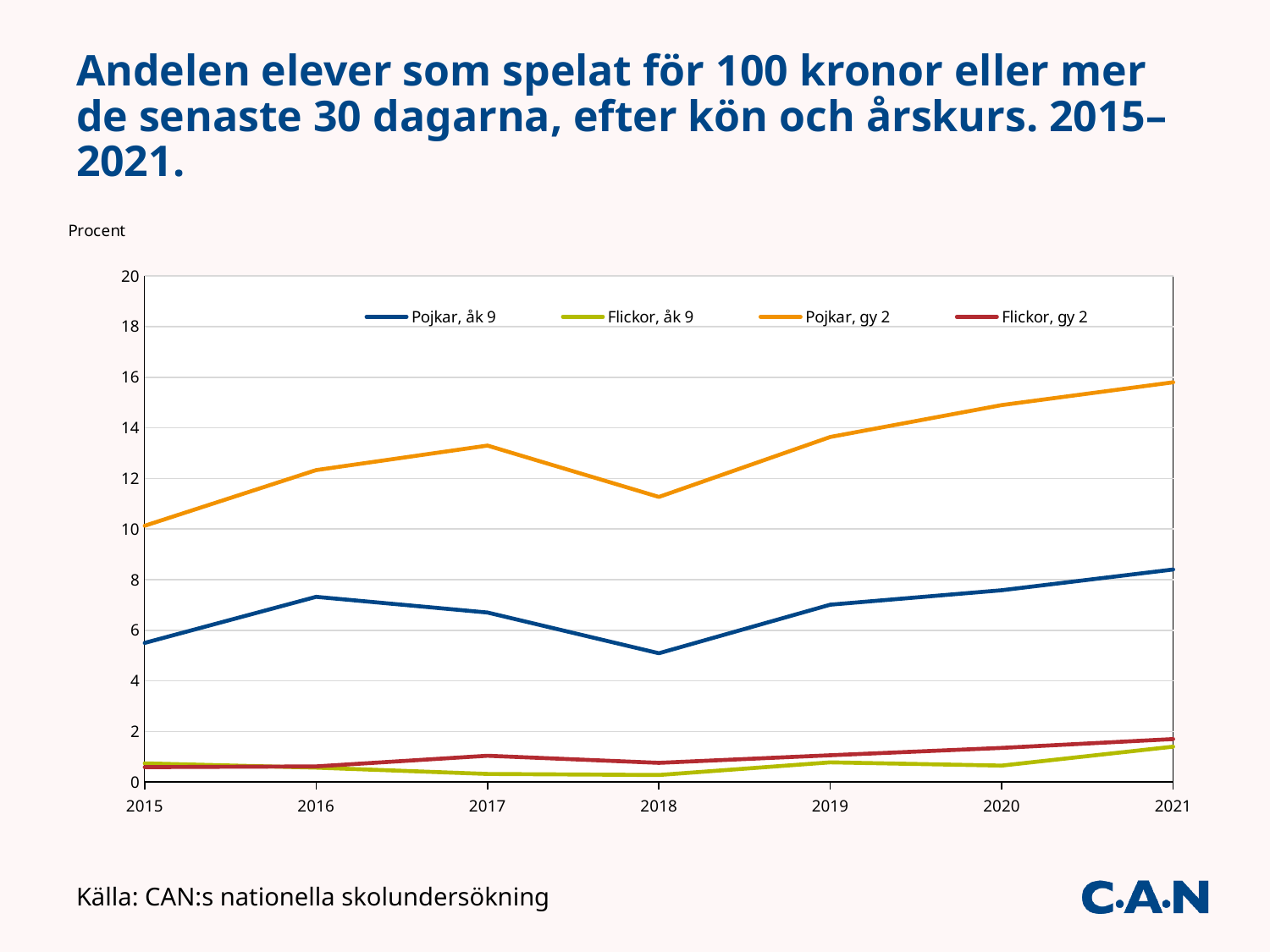
What kind of chart is shown on the slide? Line chart Does the value for Pojkar, gy 2 rise or fall from 2018 to 2021? rise Is the value for Pojkar, åk 9 in 2018 greater or less than 6? less Which series has the lowest value in 2018? Flickor, åk 9 How many series does the legend list? 4 How many years are plotted along the x axis? 7 For Pojkar, åk 9, which year has the larger value, 2016 or 2018? 2016 Is the value for Pojkar, gy 2 in 2018 greater or less than 12? less Is the value for Pojkar, gy 2 in 2021 greater or less than 14? greater Which series has the highest value in 2021? Pojkar, gy 2 What colour is the line for Pojkar, gy 2? Orange What label is shown on the vertical axis? Procent